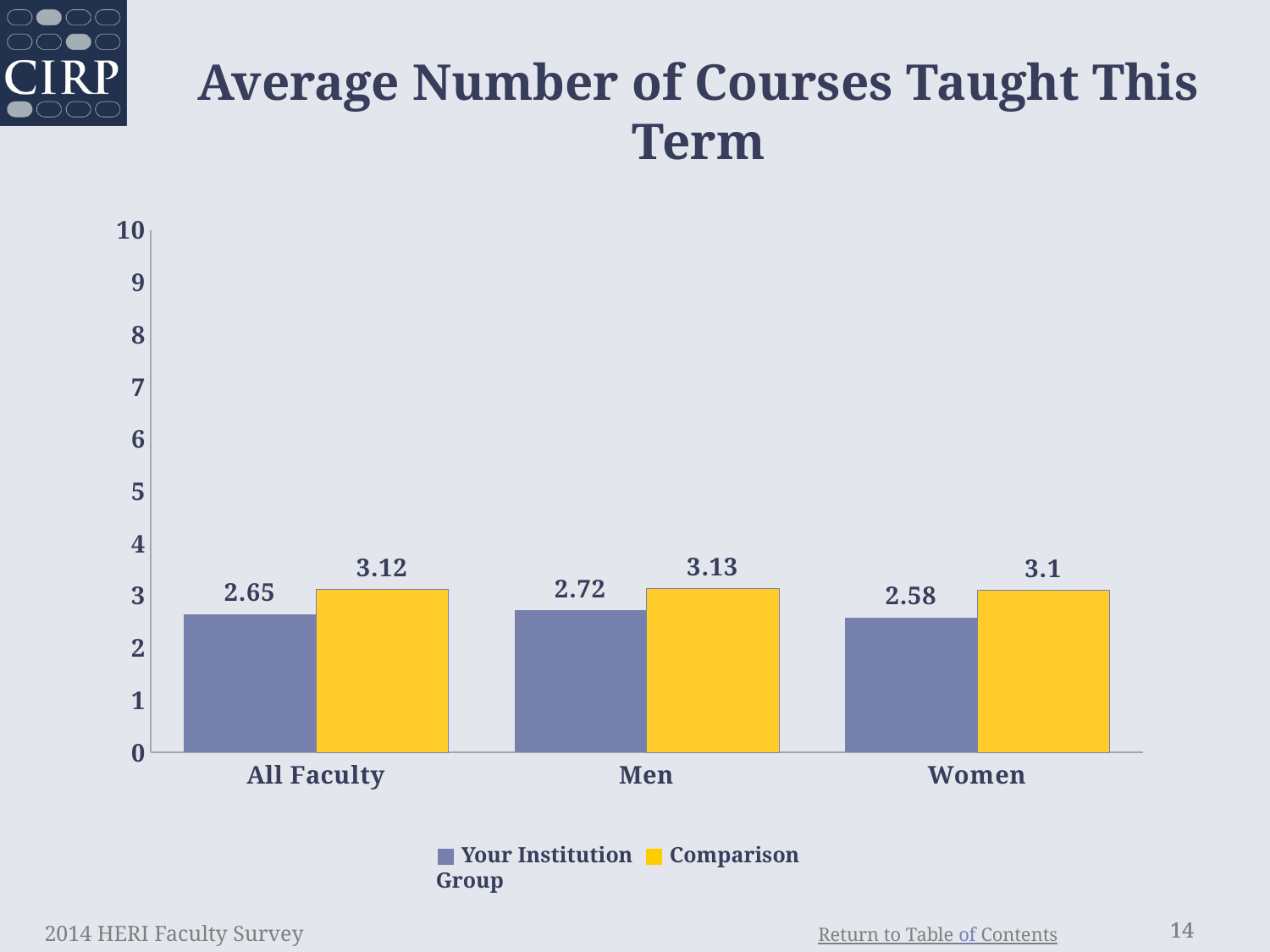
Which is larger for Men: Your Institution or Comparison Group? Comparison Group Which category has the lowest value for Your Institution? Women How many categories are shown on the x axis? 3 What is the difference between the Comparison Group and Your Institution values for All Faculty? 0.47 What kind of chart is shown on the slide? bar chart What is the value for Your Institution in the Women category? 2.58 Which category has the highest value for Your Institution? Men What is the value for Comparison Group in the Men category? 3.13 What is the value for Your Institution in the All Faculty category? 2.65 How many series does the legend list? 2 Is the value for Your Institution in the Men category greater or less than 3? less What is the value for Comparison Group in the Women category? 3.1